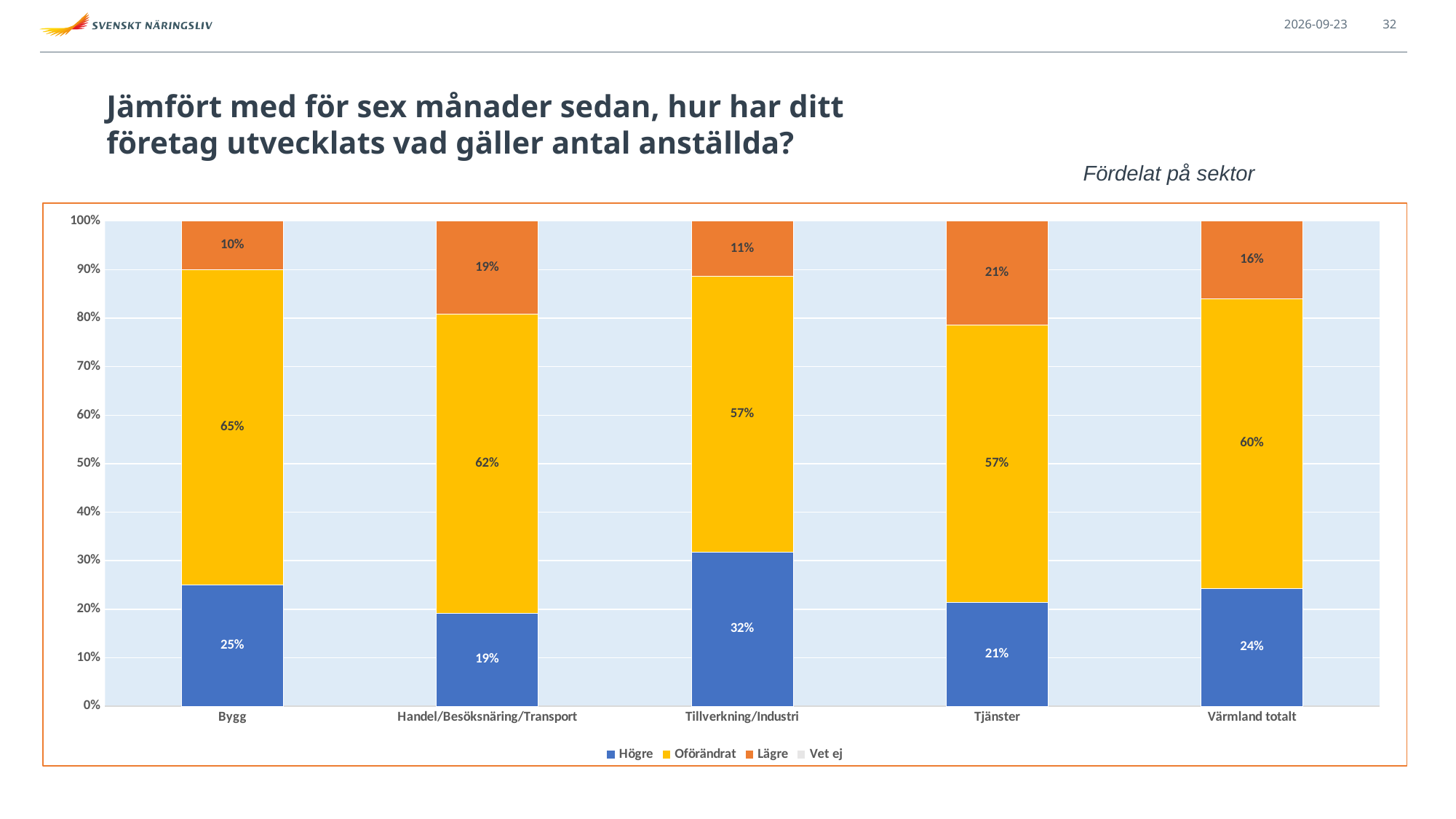
What kind of chart is shown on the slide? Stacked bar chart What is the value for Oförändrat in the Handel/Besöksnäring/Transport bar? 62% How many series does the legend list? 4 What is the value for Högre in the Tillverkning/Industri bar? 32% Which is larger, the Högre value for Bygg or the Högre value for Tjänster? Bygg What is the difference between the Lägre values for Tjänster and Bygg? 11% What is the value for Lägre in the Bygg bar? 10% Which series is shown in yellow in the chart? Oförändrat What is the value for Högre in the Värmland totalt bar? 24% Which category has the highest value for Högre? Tillverkning/Industri How many categories are shown on the x axis? 5 Which category has the lowest value for Lägre? Bygg